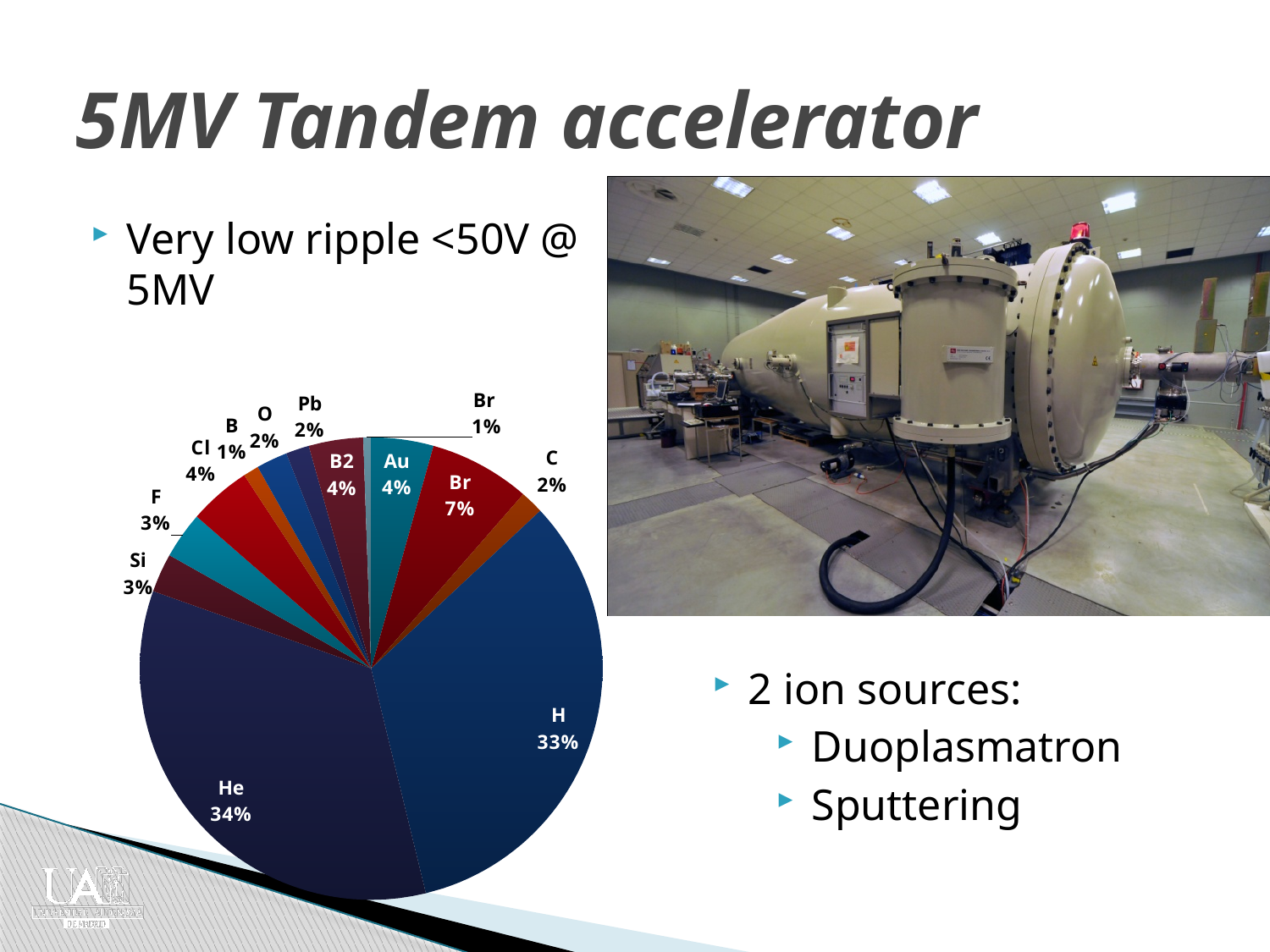
What is the value shown for Pb in the pie chart? 2% What is the value shown for F in the pie chart? 3% What share of the pie does H have? 33% Which is larger, the slice for Au or the slice for O? Au What kind of chart is shown on the slide? pie chart How many slices does the pie chart have? 13 What is the value shown for Cl in the pie chart? 4% Which category has the largest slice of the pie? He What share of the pie does He have? 34% What is the difference between the He and H shares? 1% Which is larger, the slice for Si or the slice for Cl? Cl What is the value shown for Au in the pie chart? 4%